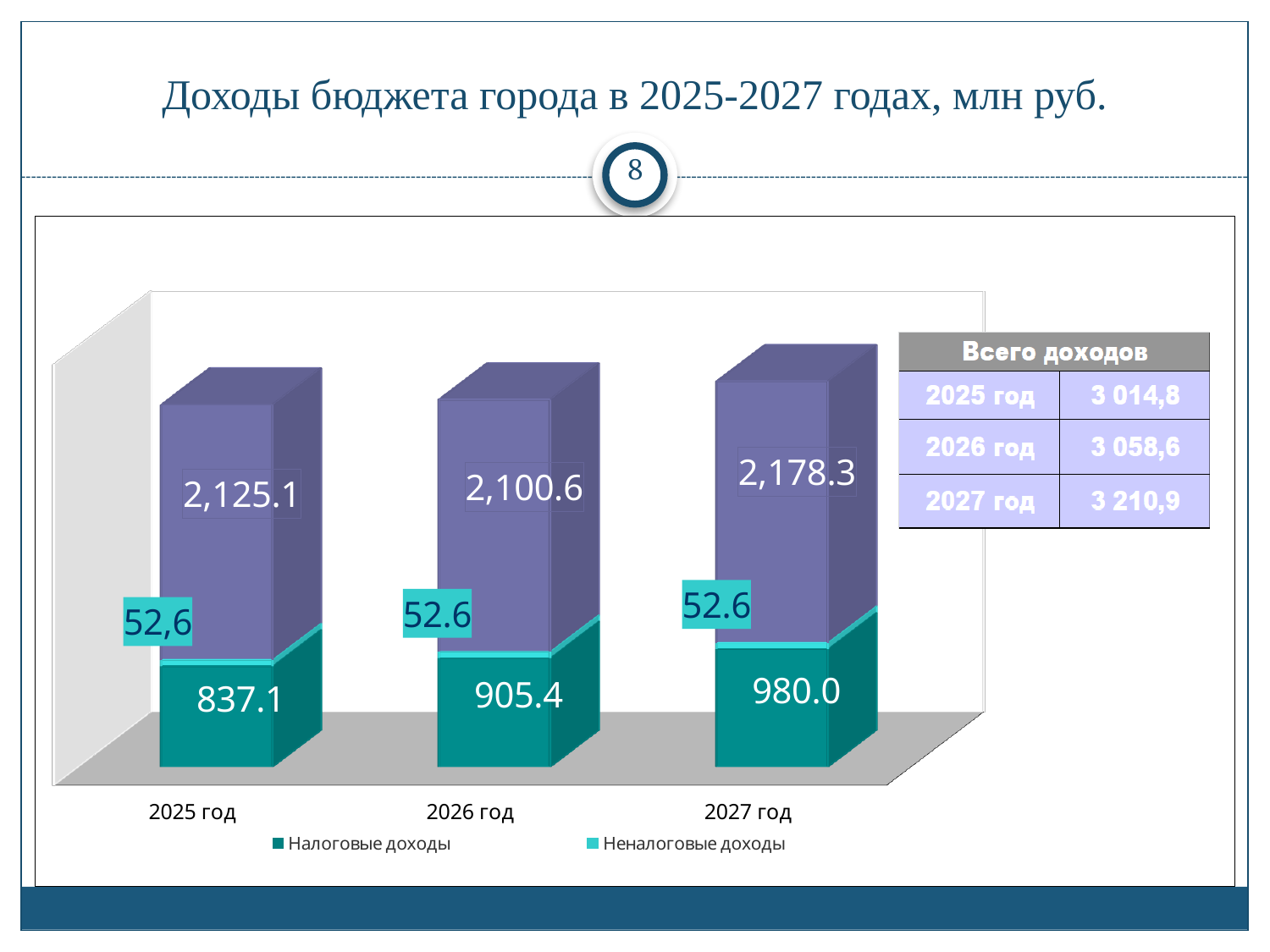
What is the value of Налоговые доходы for 2025 год? 837.1 How many series does the chart legend list? 2 What is the value of Неналоговые доходы for 2026 год? 52.6 What is the difference between Налоговые доходы in 2027 год and 2025 год? 142.9 Do the values for Налоговые доходы rise or fall from 2025 год to 2027 год? rise What kind of chart is shown on the slide? bar chart What is the value of Налоговые доходы for 2027 год? 980.0 Which is larger: Налоговые доходы in 2026 год or in 2025 год? 2026 год Which year has the highest value for Налоговые доходы? 2027 год What is the value printed on the purple top segment of the 2027 год bar? 2,178.3 Which year has the lowest value for Налоговые доходы? 2025 год How many years (categories) are shown on the x axis of the chart? 3